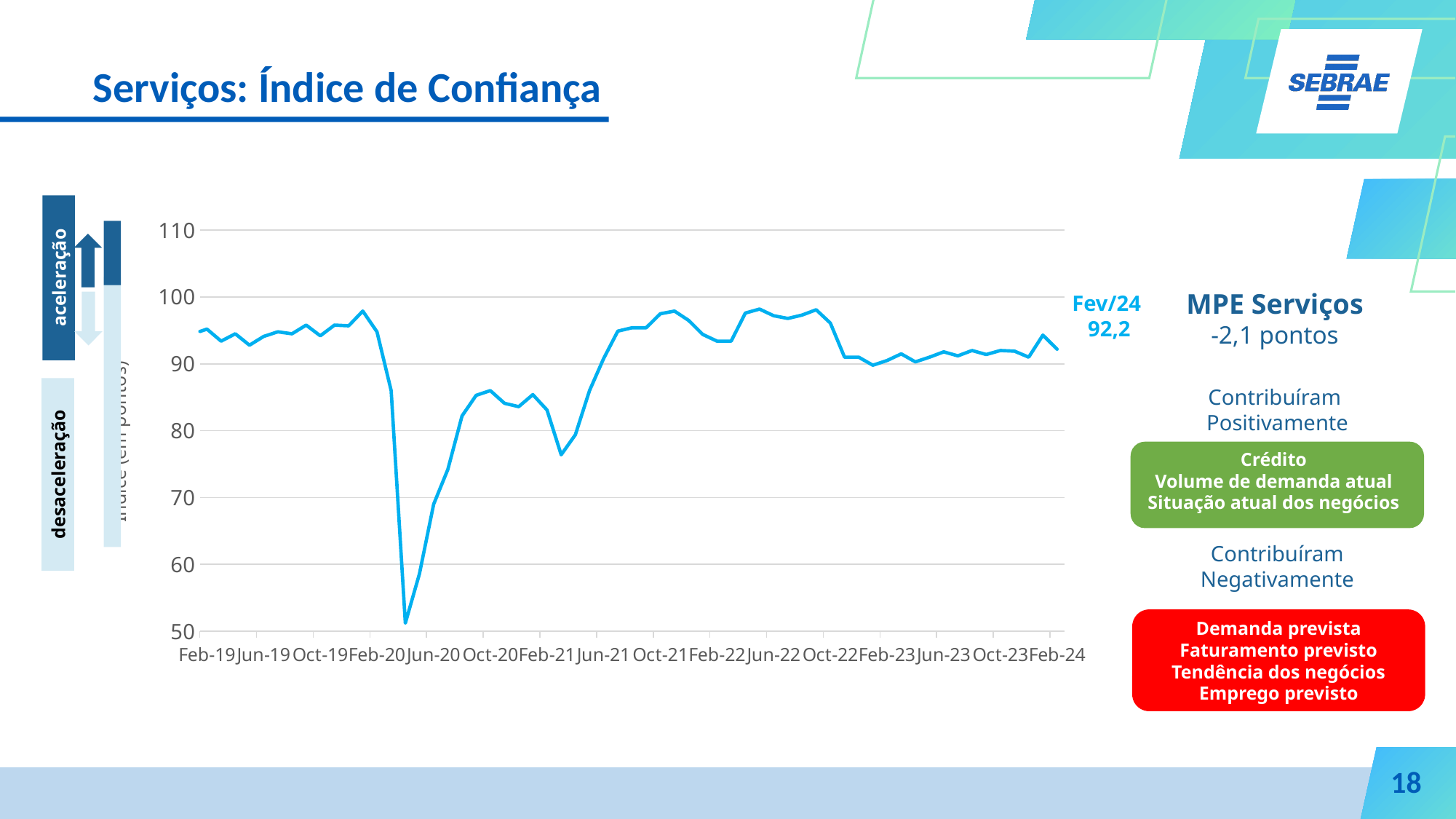
Is the value for Oct-21 greater or less than 90? greater What is the value of the index labelled for Fev/24? 92,2 What are the first and last labels on the x axis? Feb-19 and Feb-24 What kind of chart is shown on the slide? line chart Does the line rise or fall from Jun-20 to Jun-21? rise Is the lowest point of the line greater or less than 60? less Between which two labelled x-axis dates does the line reach its lowest point? Feb-20 and Jun-20 Is the value for Feb-24 greater or less than 100? less Does the line rise or fall from Feb-20 to Jun-20? fall Which is larger, the value at Feb-20 or the value at Feb-24? Feb-20 How many lines are plotted on the chart? 1